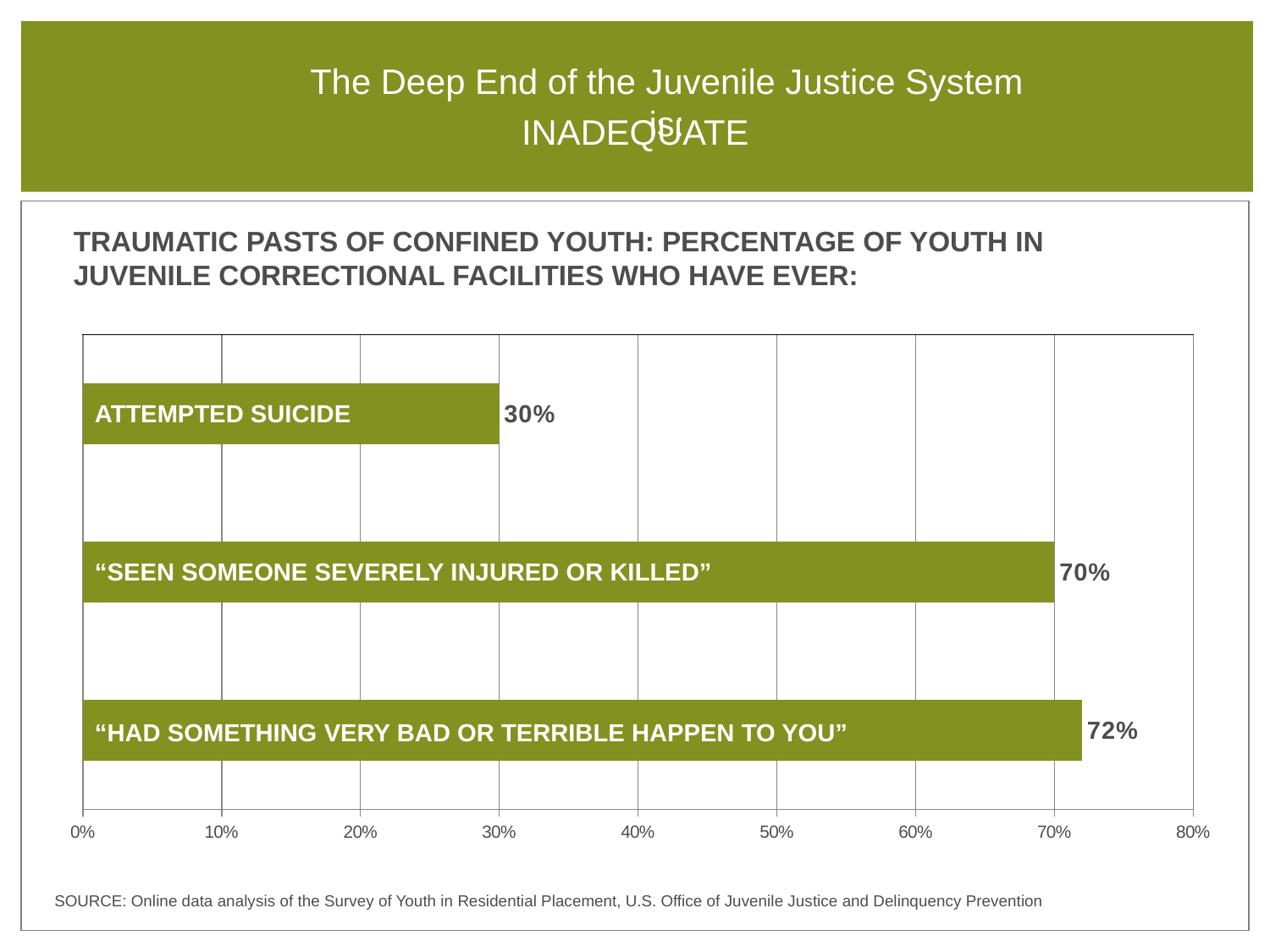
Which is larger: the percentage who "seen someone severely injured or killed" or the percentage who attempted suicide? "Seen someone severely injured or killed" What is the difference between the percentage who "had something very bad or terrible happen to you" and the percentage who attempted suicide? 42% What is the maximum value shown on the horizontal axis? 80% What percentage of youth have "had something very bad or terrible happen to you"? 72% What kind of chart is shown on the slide? Bar chart What is the difference between the percentage who "seen someone severely injured or killed" and the percentage who attempted suicide? 40% How many categories are shown in the chart? 3 Which category has the lowest percentage? Attempted suicide What percentage of youth have "seen someone severely injured or killed"? 70% Which category has the highest percentage? "Had something very bad or terrible happen to you" What percentage of youth in juvenile correctional facilities have attempted suicide? 30% Is the value for attempted suicide greater or less than 50%? less